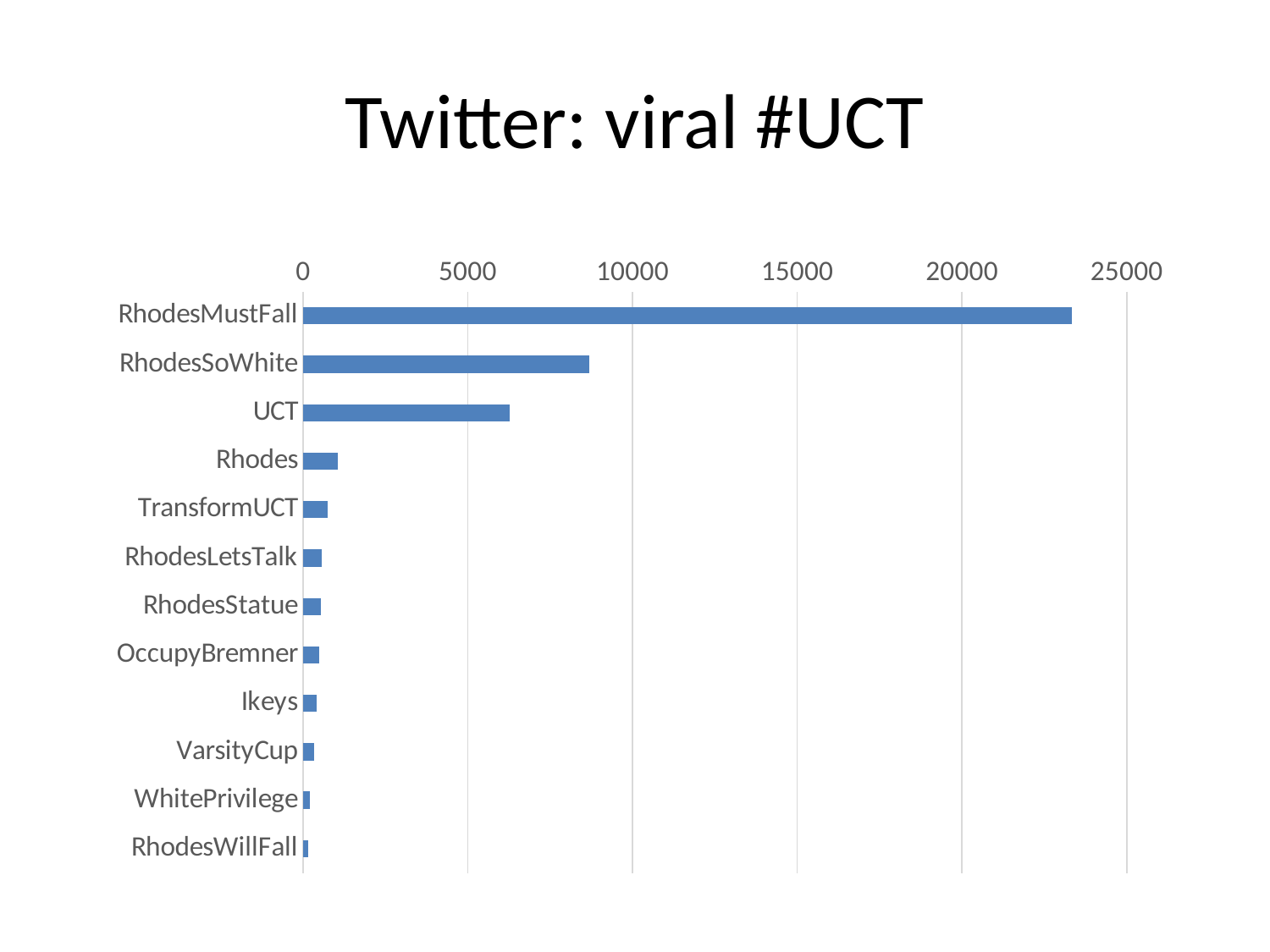
Is the value for RhodesMustFall greater or less than 20000? greater Is the value for RhodesSoWhite greater or less than 5000? greater Is the value for RhodesSoWhite greater or less than 10000? less Which hashtag has the highest value in the chart? RhodesMustFall Which has a larger value, RhodesSoWhite or UCT? RhodesSoWhite What kind of chart is shown on the slide? bar chart Which has a larger value, Rhodes or TransformUCT? Rhodes Do the bar values increase or decrease going from the top of the chart to the bottom? decrease What is the title of the slide? Twitter: viral #UCT How many hashtags (categories) are plotted in the chart? 12